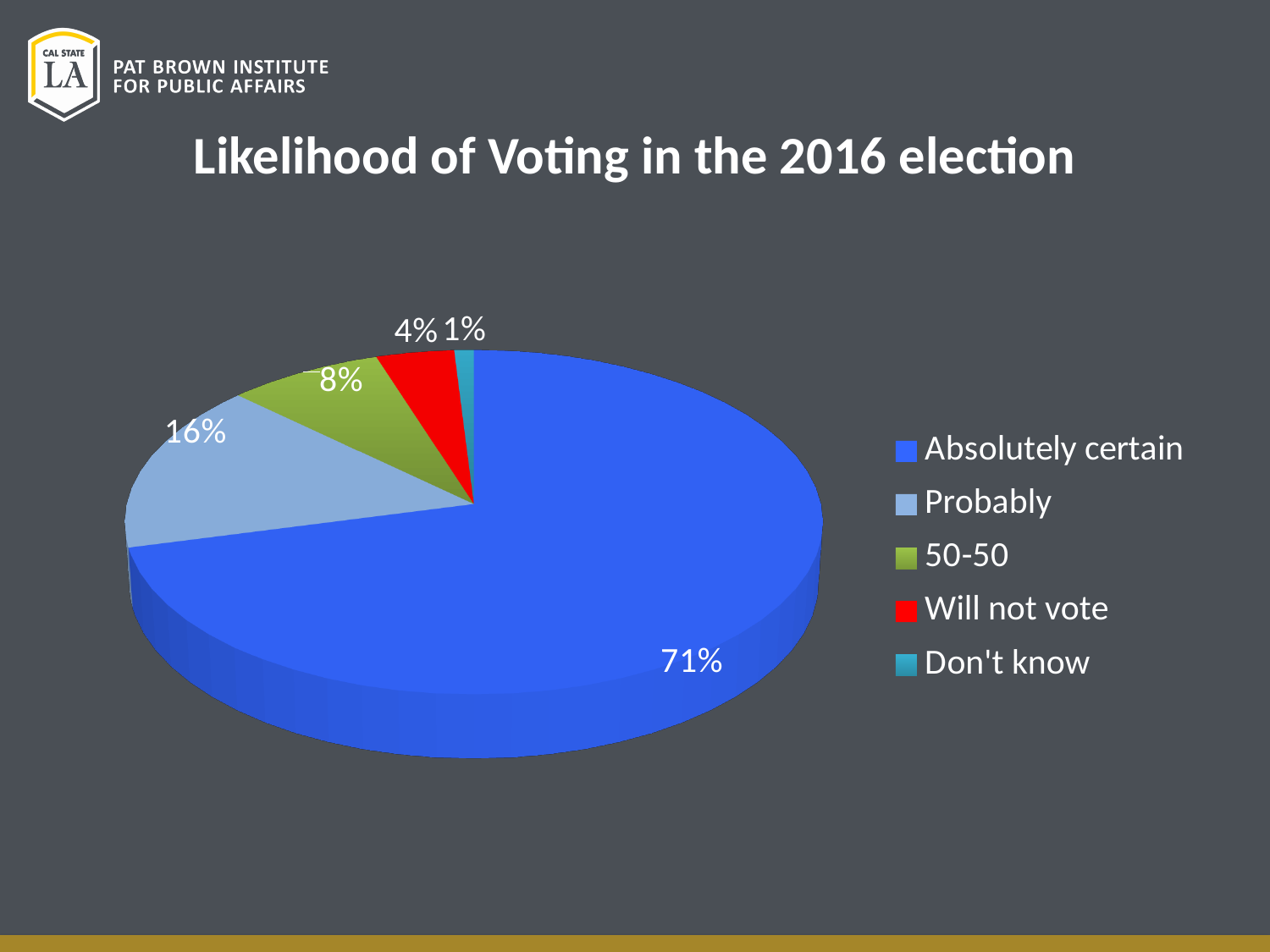
What percentage of respondents said they 'Will not vote'? 4% Which is larger, the '50-50' share or the 'Will not vote' share? 50-50 Which category has the largest share of the pie? Absolutely certain How many categories does the legend list? 5 Which category has the smallest share of the pie? Don't know What percentage of respondents are 'Absolutely certain' to vote? 71% What percentage of respondents answered 'Probably'? 16% What is the title of the chart? Likelihood of Voting in the 2016 election What percentage of respondents answered 'Don't know'? 1% What kind of chart is shown on the slide? Pie chart What percentage of respondents answered '50-50'? 8% What is the difference between the 'Absolutely certain' and 'Probably' shares? 55%